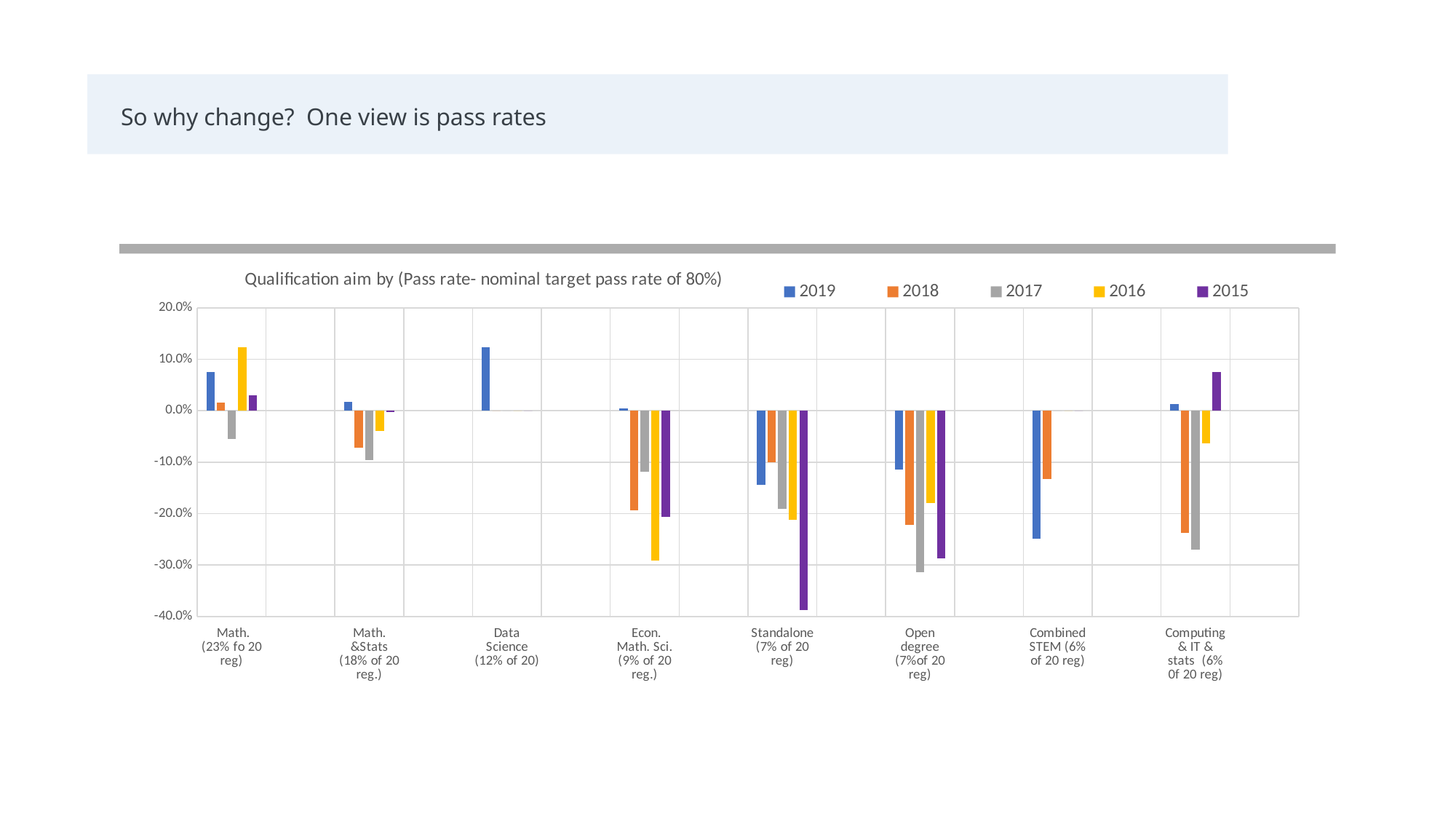
How many series does the legend list? 5 For Standalone, which year has the lowest value? 2015 How many qualification aim categories are shown on the x axis? 8 Is the 2019 value for Combined STEM greater or less than -20.0%? less What kind of chart is shown on the slide? bar chart Is the 2016 value for Econ. Math. Sci. greater or less than -20.0%? less What is the title of the chart? Qualification aim by (Pass rate- nominal target pass rate of 80%) Which category and year has the lowest value in the chart? Standalone, 2015 Is the 2019 value for Data Science greater or less than 10.0%? greater For Computing & IT & stats, which year has the highest value? 2015 For Combined STEM, which is larger, the 2019 value or the 2018 value? 2018